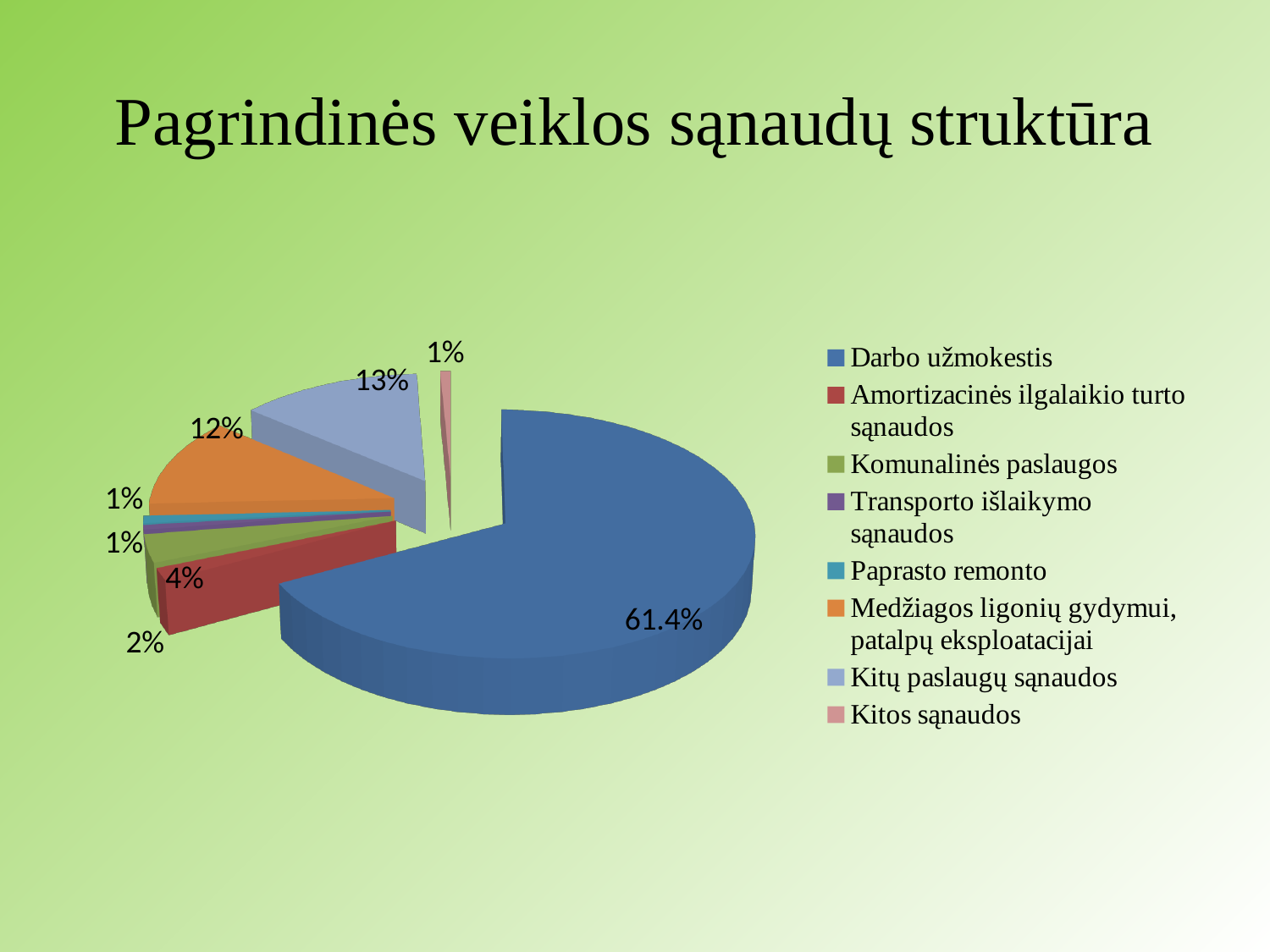
How many categories does the legend list? 8 What is the difference in percentage points between the share for Darbo užmokestis and the share for Kitų paslaugų sąnaudos? 48.4 Which category has the largest share of the pie? Darbo užmokestis What share of the pie does Kitų paslaugų sąnaudos have? 13% How many slices does the pie chart have? 8 What share of the pie does Darbo užmokestis have? 61.4% What share of the pie does Medžiagos ligonių gydymui, patalpų eksploatacijai have? 12% What colour is the slice for Darbo užmokestis? blue Which is larger: the share for Kitų paslaugų sąnaudos or the share for Medžiagos ligonių gydymui, patalpų eksploatacijai? Kitų paslaugų sąnaudos What is the title of the chart? Pagrindinės veiklos sąnaudų struktūra What kind of chart is shown on the slide? pie chart